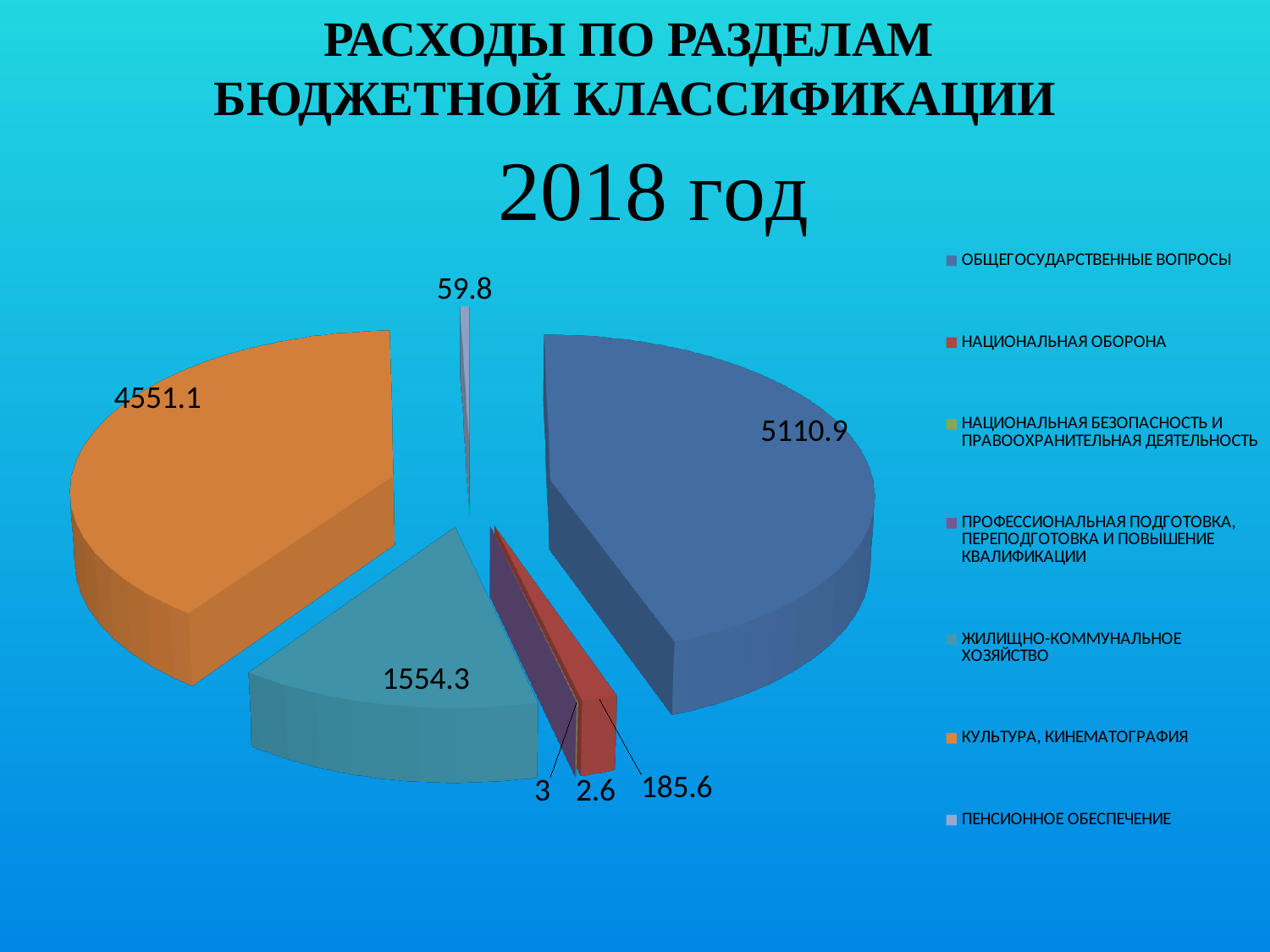
How many categories does the legend list? 7 Which category has the largest value? ОБЩЕГОСУДАРСТВЕННЫЕ ВОПРОСЫ What is the value for ПЕНСИОННОЕ ОБЕСПЕЧЕНИЕ? 59.8 What type of chart is shown on the slide? Pie chart Which is larger, the value for КУЛЬТУРА, КИНЕМАТОГРАФИЯ or the value for ЖИЛИЩНО-КОММУНАЛЬНОЕ ХОЗЯЙСТВО? КУЛЬТУРА, КИНЕМАТОГРАФИЯ What year is shown in the chart title? 2018 What is the value for КУЛЬТУРА, КИНЕМАТОГРАФИЯ? 4551.1 What is the value for ОБЩЕГОСУДАРСТВЕННЫЕ ВОПРОСЫ? 5110.9 What is the value for ЖИЛИЩНО-КОММУНАЛЬНОЕ ХОЗЯЙСТВО? 1554.3 What is the value for НАЦИОНАЛЬНАЯ ОБОРОНА? 185.6 What is the difference between the values for ОБЩЕГОСУДАРСТВЕННЫЕ ВОПРОСЫ and КУЛЬТУРА, КИНЕМАТОГРАФИЯ? 559.8 What is the difference between the values for НАЦИОНАЛЬНАЯ ОБОРОНА and ПЕНСИОННОЕ ОБЕСПЕЧЕНИЕ? 125.8